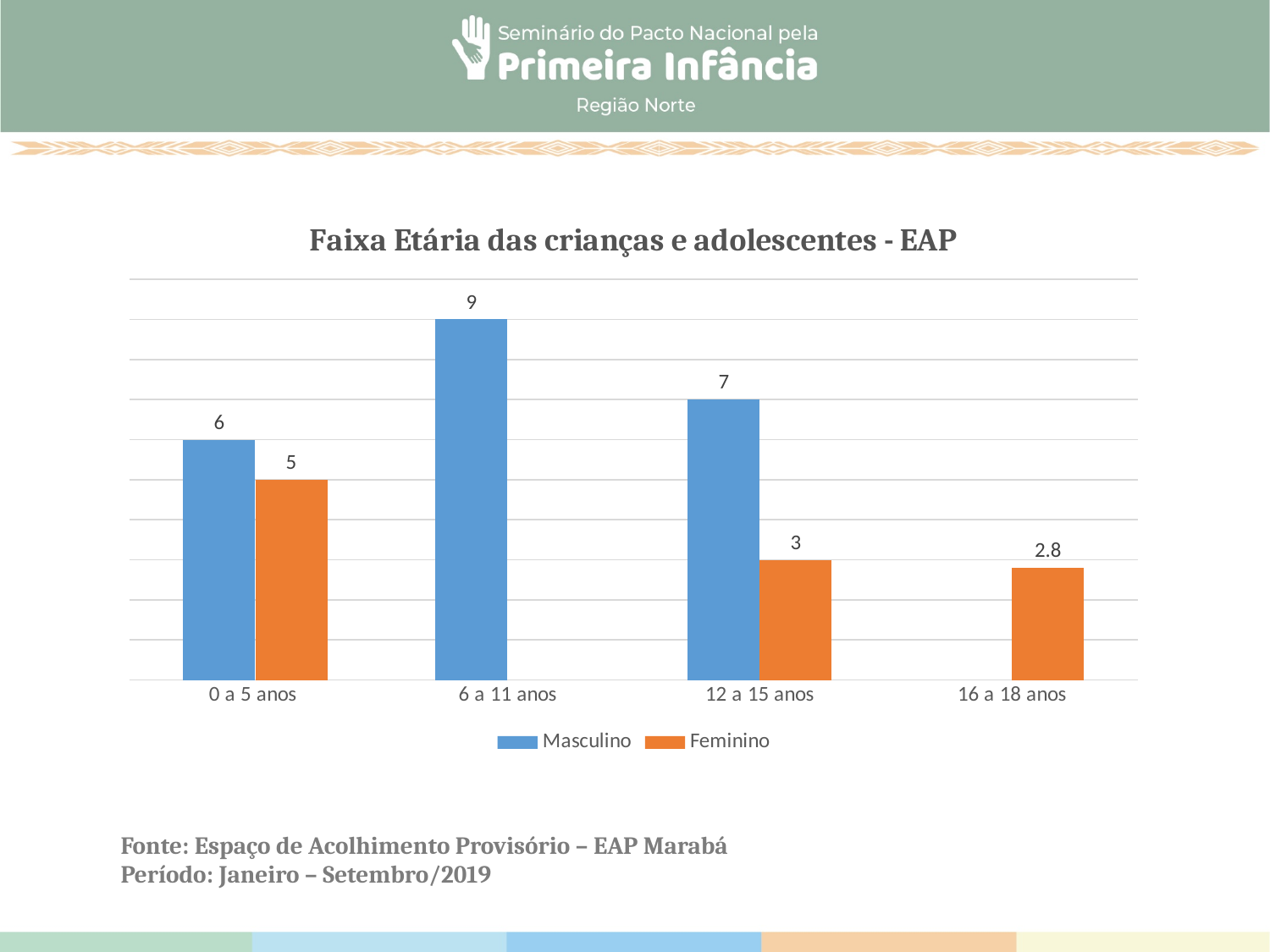
What is the difference between the Masculino and Feminino values for 12 a 15 anos? 4 Which age category has the lowest Feminino value? 16 a 18 anos How many age categories are shown on the x axis? 4 What is the title of the chart? Faixa Etária das crianças e adolescentes - EAP How many series does the legend list? 2 What is the Feminino value for the 16 a 18 anos category? 2.8 What is the Masculino value for the 0 a 5 anos category? 6 What kind of chart is shown on the slide? Bar chart Which colour represents the Feminino series? Orange Which age category has the highest Masculino value? 6 a 11 anos Which is larger for 0 a 5 anos, the Masculino value or the Feminino value? Masculino What is the Feminino value for the 12 a 15 anos category? 3